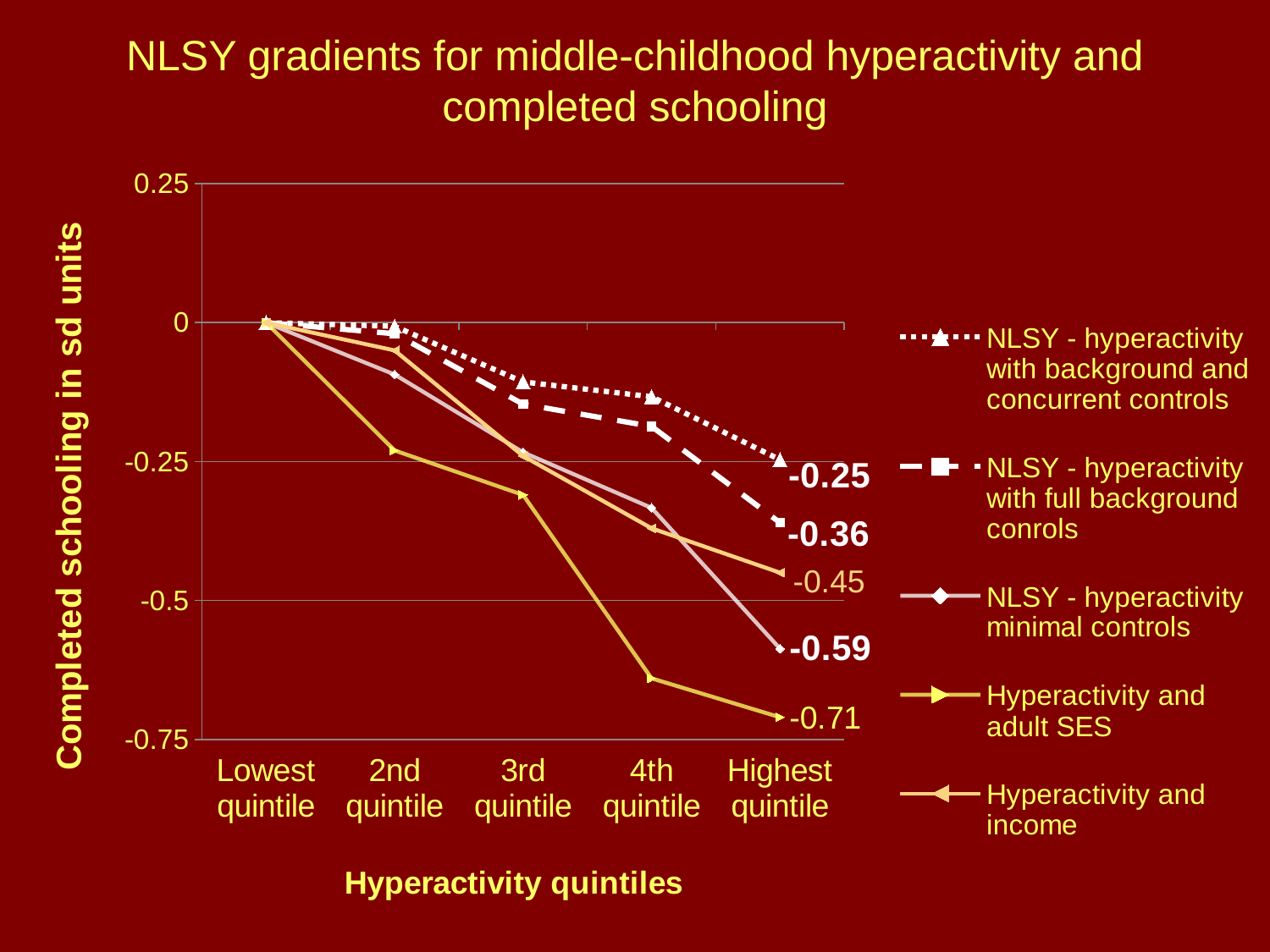
Is the value for 'Hyperactivity and adult SES' at the 4th quintile greater or less than -0.5? less What kind of chart is shown on the slide? line chart What is the value for 'NLSY - hyperactivity minimal controls' at the highest quintile? -0.59 What is the difference between the highest-quintile values for 'NLSY - hyperactivity with background and concurrent controls' (-0.25) and 'Hyperactivity and adult SES' (-0.71)? 0.46 What is the value for 'Hyperactivity and adult SES' at the highest quintile? -0.71 How many series does the legend list? 5 Which series has the lowest value at the highest quintile? Hyperactivity and adult SES What is the value for 'Hyperactivity and income' at the highest quintile? -0.45 What is the value for 'NLSY - hyperactivity with background and concurrent controls' at the highest quintile? -0.25 How many hyperactivity quintiles are shown on the x axis? 5 What is the value for 'NLSY - hyperactivity with full background conrols' at the highest quintile? -0.36 Do the values for 'Hyperactivity and adult SES' rise or fall from the lowest quintile to the highest quintile? fall